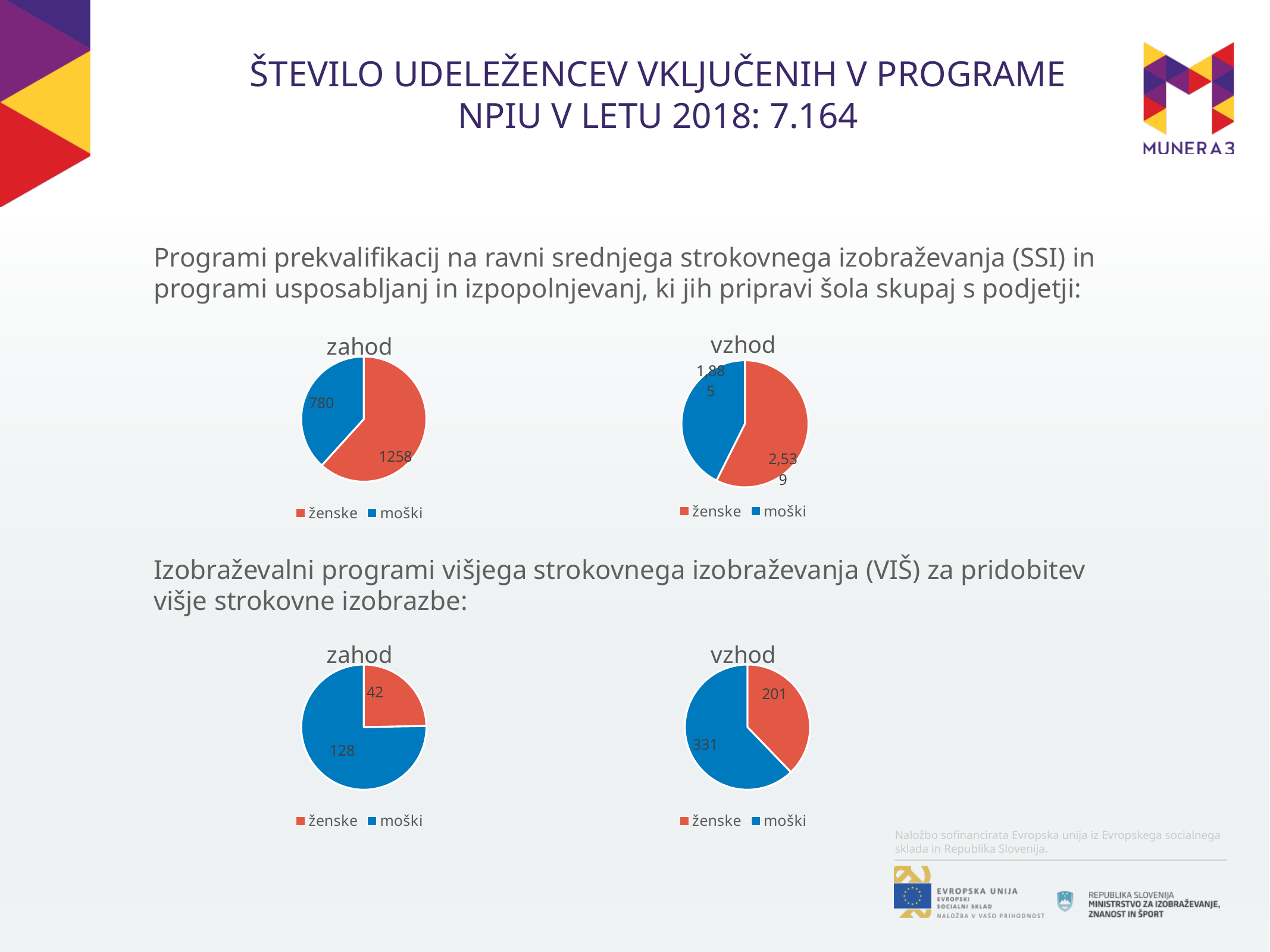
In the bottom-left pie chart (zahod, VIŠ section), what is the value for moški? 128 In the bottom-right pie chart (vzhod, VIŠ section), what is the difference between moški and ženske? 130 In the top-left pie chart (zahod, SSI section), what is the difference between ženske and moški? 478 In the bottom-left pie chart (zahod, VIŠ section), what is the value for ženske? 42 In the bottom-left pie chart (zahod, VIŠ section), what is the total of the two slices? 170 In the top-left pie chart (zahod, SSI section), which slice is larger, ženske or moški? ženske In the bottom-right pie chart (vzhod, VIŠ section), what is the value for moški? 331 In the top-left pie chart (zahod, SSI section), what is the value for moški? 780 In the top-left pie chart (zahod, SSI section), what is the value for ženske? 1258 What type of chart is the bottom-right chart titled vzhod? pie chart How many entries does the legend of the bottom-left pie chart (zahod, VIŠ section) list? 2 In the top-right pie chart (vzhod, SSI section), which slice is larger, ženske or moški? ženske